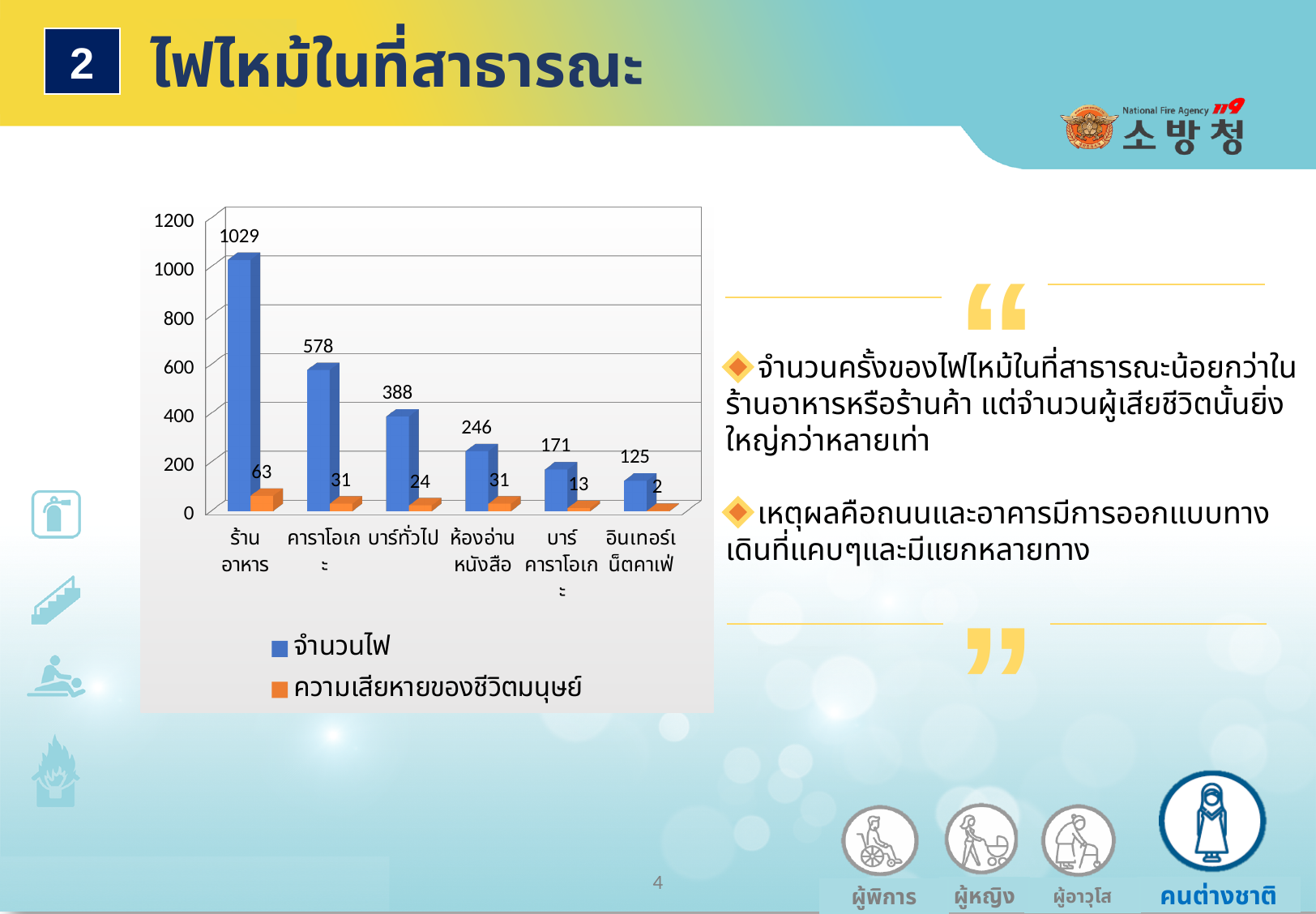
Which category has the highest จำนวนไฟ value? ร้านอาหาร Do the จำนวนไฟ values rise or fall from left to right along the x axis? fall How many series does the legend list? 2 How many categories are shown on the x axis? 6 What is the ความเสียหายของชีวิตมนุษย์ value for คาราโอเกะ? 31 What is the difference between the จำนวนไฟ values for ร้านอาหาร and คาราโอเกะ? 451 Which category has the lowest ความเสียหายของชีวิตมนุษย์ value? อินเทอร์เน็ตคาเฟ่ Which is larger, the ความเสียหายของชีวิตมนุษย์ value for บาร์ทั่วไป or for ห้องอ่านหนังสือ? ห้องอ่านหนังสือ Is the จำนวนไฟ value for บาร์ทั่วไป greater or less than 400? less What is the จำนวนไฟ value for อินเทอร์เน็ตคาเฟ่? 125 What kind of chart is shown on the slide? bar chart What is the จำนวนไฟ value for ร้านอาหาร? 1029